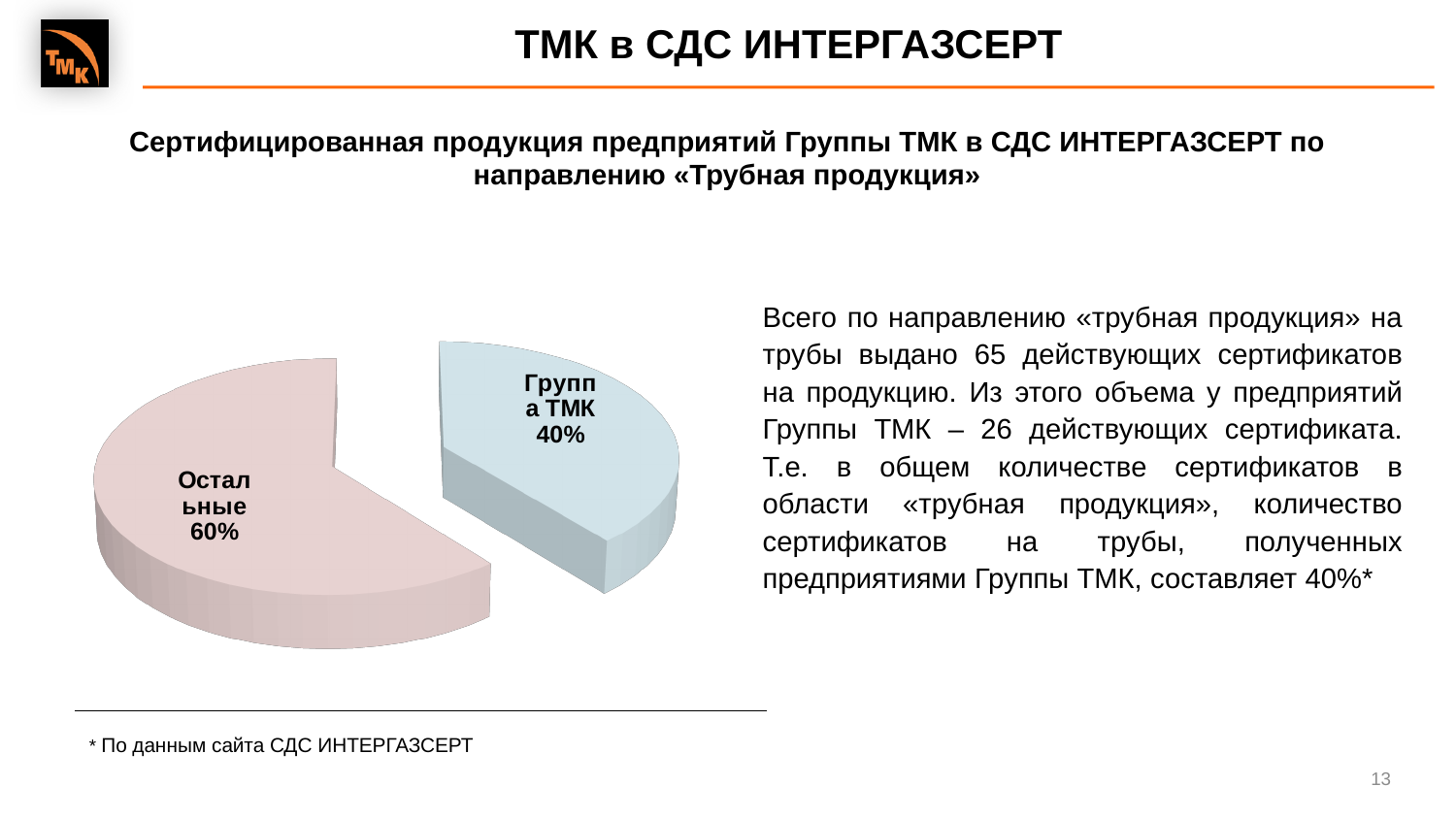
Is the share for «Группа ТМК» greater or less than 50%? less What is the difference in percentage points between the «Остальные» slice and the «Группа ТМК» slice? 20% What share of the pie does the slice labelled «Группа ТМК» represent? 40% What colour is the «Остальные» slice of the pie? Pink Which is larger: the «Группа ТМК» slice or the «Остальные» slice? Остальные What is the total of the two slices shown in the pie chart? 100% What kind of chart is shown on the slide? Pie chart Which slice of the pie is pulled out (exploded) from the rest of the pie? Группа ТМК Which slice of the pie is the largest? Остальные Which slice of the pie is the smallest? Группа ТМК What share of the pie does the slice labelled «Остальные» represent? 60% How many slices does the pie chart have? 2